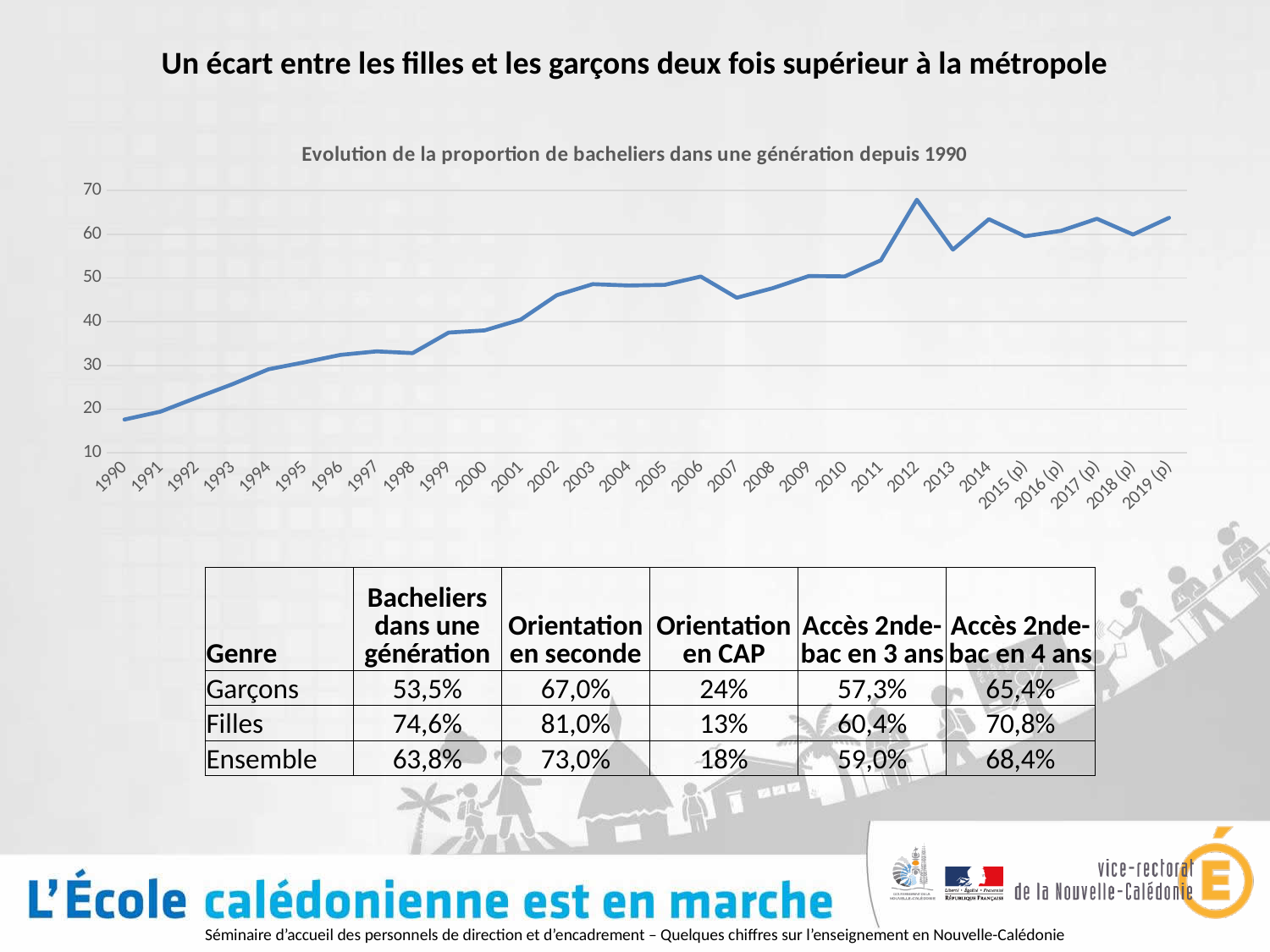
Which year has the higher value, 2006 or 2007? 2006 Is the value for 2012 greater or less than 60? greater What is the title of the chart? Evolution de la proportion de bacheliers dans une génération depuis 1990 How many years are plotted on the x axis of the chart? 30 What kind of chart is shown on the slide? line chart Is the value for 1990 greater or less than 20? less Which year has the higher value, 2012 or 2013? 2012 In which year does the line have its lowest value? 1990 In which year does the line reach its highest value? 2012 Is the value for 2019 (p) greater or less than 60? greater Overall, does the proportion of bacheliers rise or fall from 1990 to 2019 (p)? rise